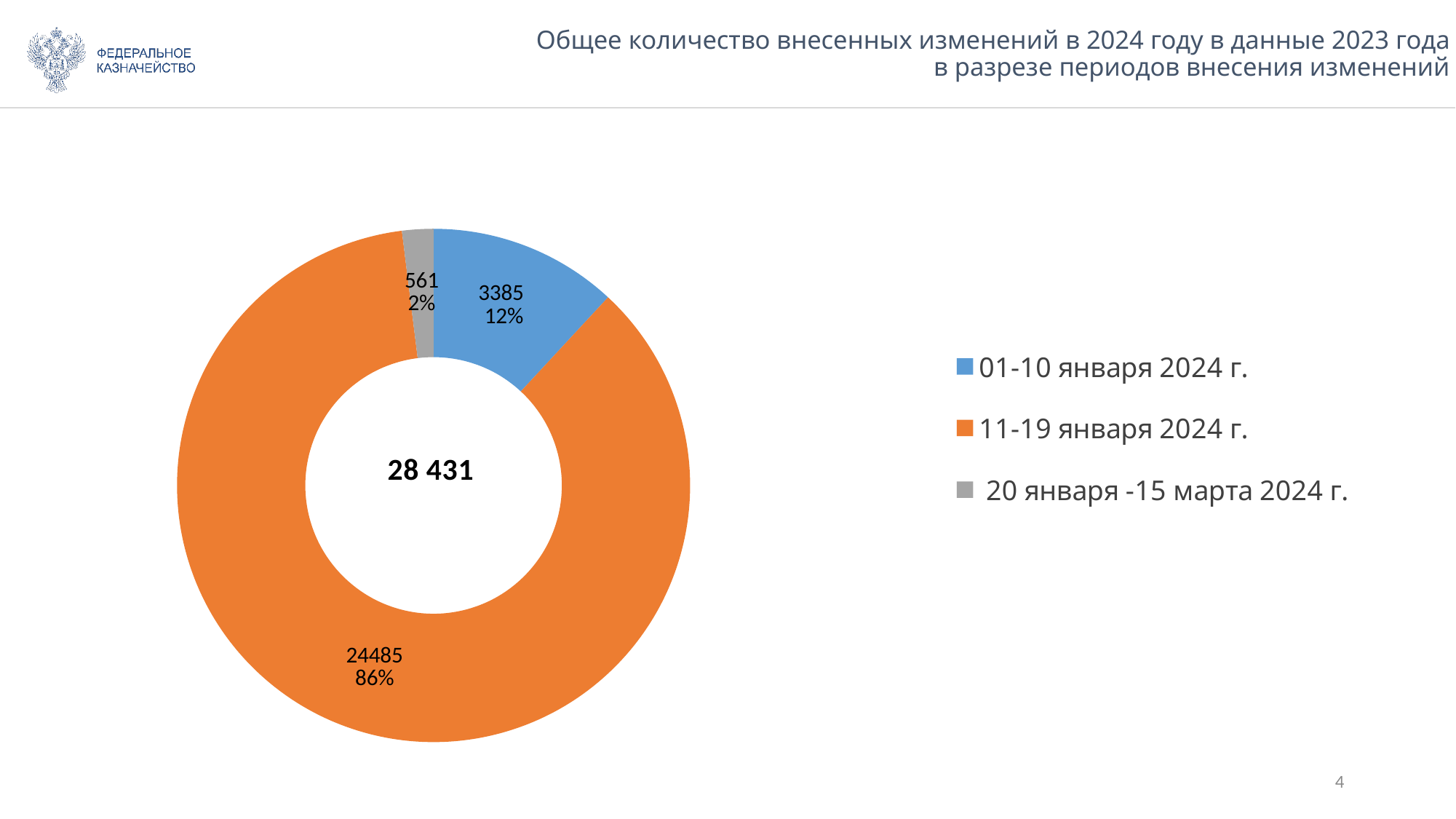
How many periods (slices) does the chart show? 3 What total is shown in the centre of the chart? 28 431 Which period has the lowest number of changes? 20 января -15 марта 2024 г. What is the difference between the values for 11-19 января 2024 г. and 01-10 января 2024 г.? 21100 Which is larger: the value for 01-10 января 2024 г. or for 20 января -15 марта 2024 г.? 01-10 января 2024 г. What share of the chart does the period 01-10 января 2024 г. represent? 12% What value is shown for the period 11-19 января 2024 г.? 24485 What value is shown for the period 01-10 января 2024 г.? 3385 What share of the chart does the period 20 января -15 марта 2024 г. represent? 2% What value is shown for the period 20 января -15 марта 2024 г.? 561 Which period has the highest number of changes? 11-19 января 2024 г. What share of the chart does the period 11-19 января 2024 г. represent? 86%